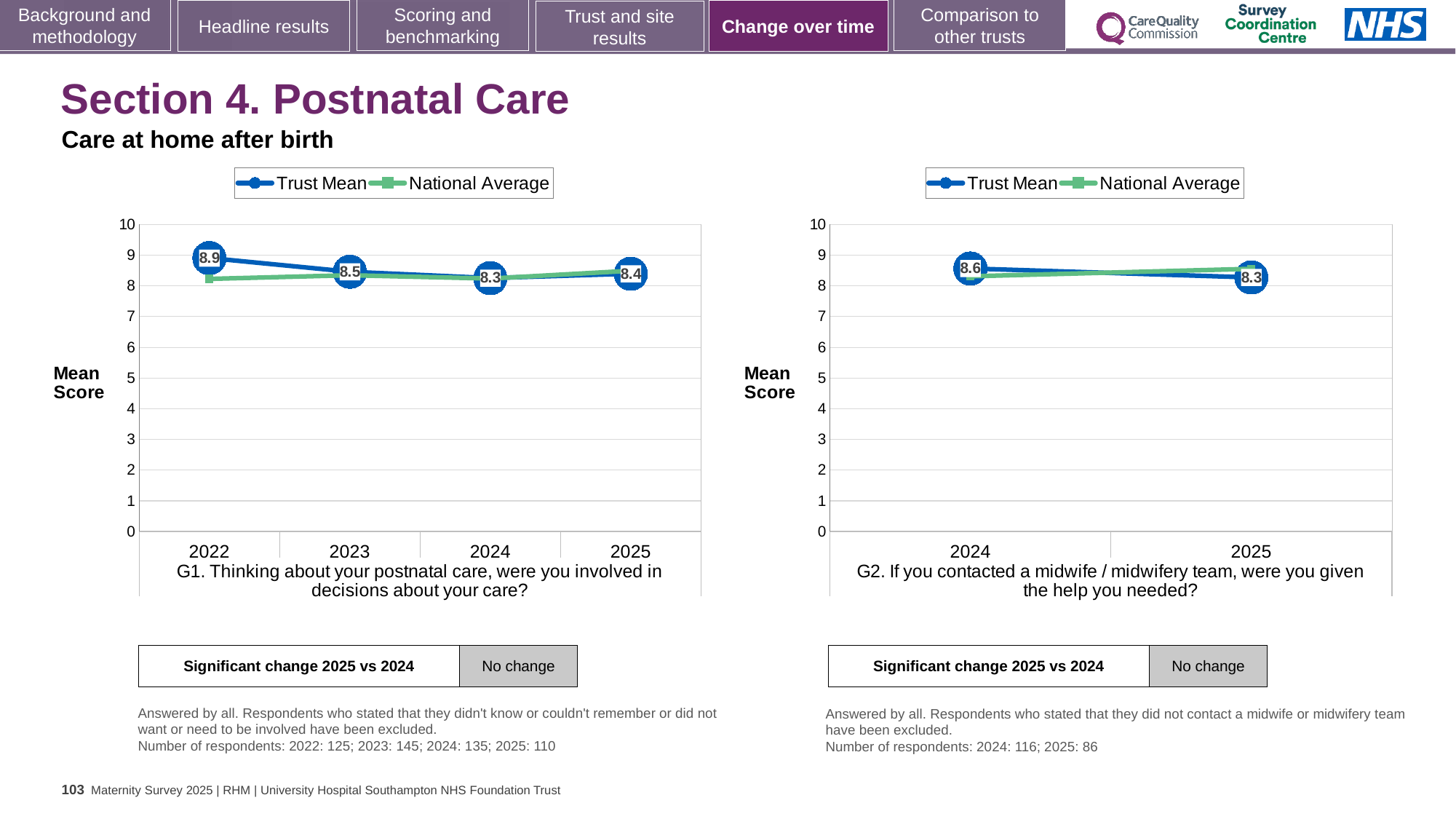
In the G1 chart on the left, is the National Average for 2022 greater or less than 9? less In the G1 chart on the left, is the Trust Mean higher in 2023 or 2024? 2023 In the G1 chart on the left, which year has the highest Trust Mean? 2022 In the G1 chart on the left, what is the Trust Mean for 2022? 8.9 In the G2 chart on the right, what is the Trust Mean for 2025? 8.3 In the G1 chart on the left, which year has the lowest Trust Mean? 2024 How many years are shown on the x axis of the G1 chart on the left? 4 In the G2 chart on the right, what is the Trust Mean for 2024? 8.6 In the G1 chart on the left, what is the difference between the Trust Mean for 2022 and 2025? 0.5 In the G1 chart on the left, what is the Trust Mean for 2025? 8.4 How many series does the legend of the G2 chart on the right list? 2 In the G2 chart on the right, what is the difference between the Trust Mean for 2024 and 2025? 0.3